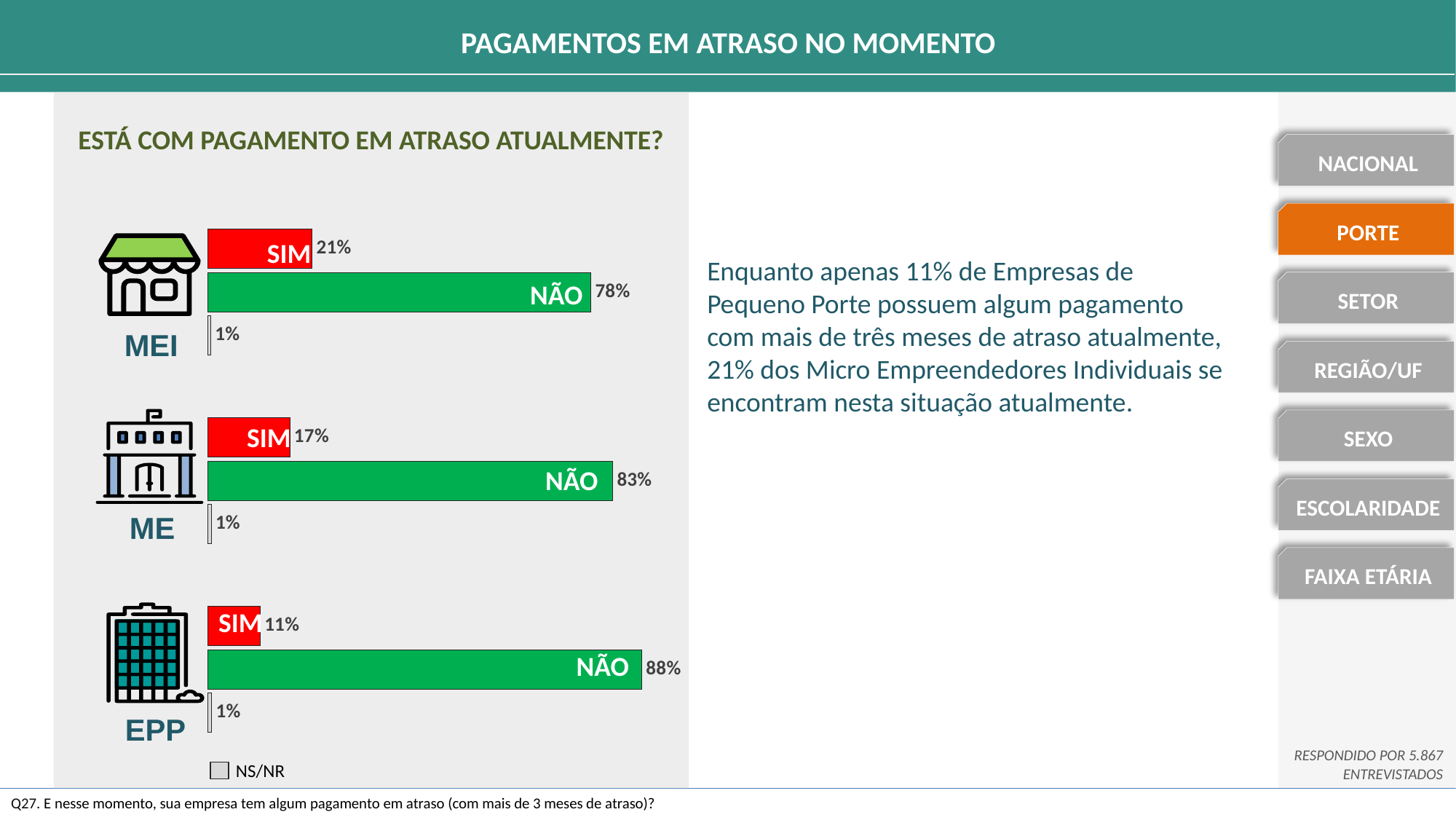
What type of chart is used to show the SIM, NÃO and NS/NR responses for each group? Bar chart In the MEI chart, what percentage answered SIM? 21% What is the difference between the SIM percentage for MEI and the SIM percentage for EPP? 10 percentage points In the EPP chart, what percentage answered NÃO? 88% In the MEI chart, what is the value for NS/NR? 1% Across the three charts (MEI, ME, EPP), which group has the highest SIM percentage? MEI In the ME chart, what percentage answered NÃO? 83% Across the three charts (MEI, ME, EPP), which group has the lowest NÃO percentage? MEI Is the SIM percentage larger for ME or for EPP? ME How many response categories are shown in each chart (MEI, ME, EPP)? 3 In the EPP chart, what percentage answered SIM? 11% In the MEI chart, what is the difference between the NÃO and SIM percentages? 57 percentage points